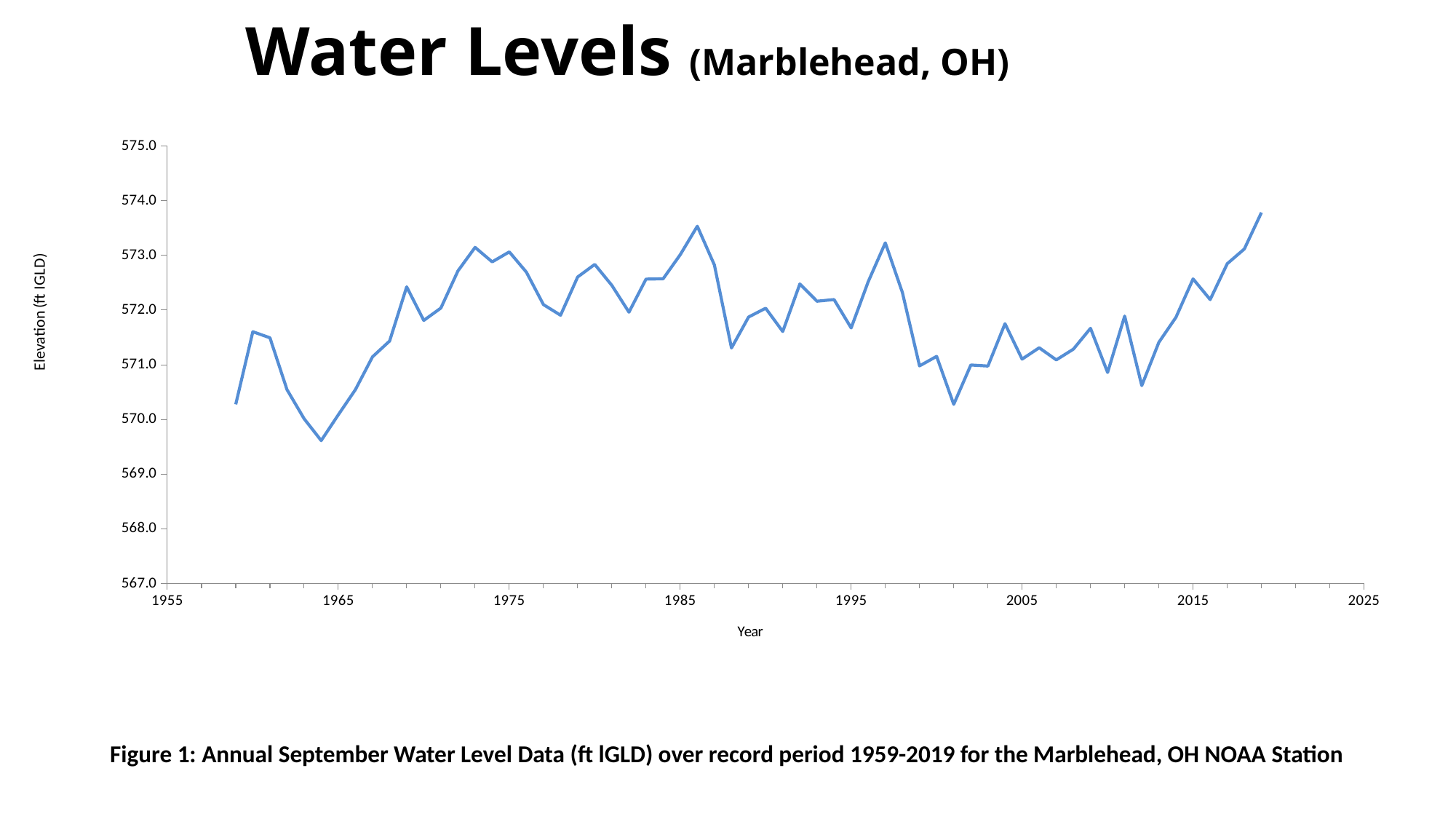
Which year has the higher water level, 1986 or 2001? 1986 Is the value for 1964 greater or less than 570.0? less What is the title of the x axis? Year In which year does the water level reach its highest point? 2019 What kind of chart is shown on the slide? line chart What is the title of the y axis? Elevation (ft IGLD) Is the value for 2001 greater or less than 571.0? less Is the value for 2012 greater or less than 571.0? less In which year does the water level reach its lowest point? 1964 Does the water level rise or fall between 1964 and 1973? rise Does the water level rise or fall between 1997 and 2001? fall